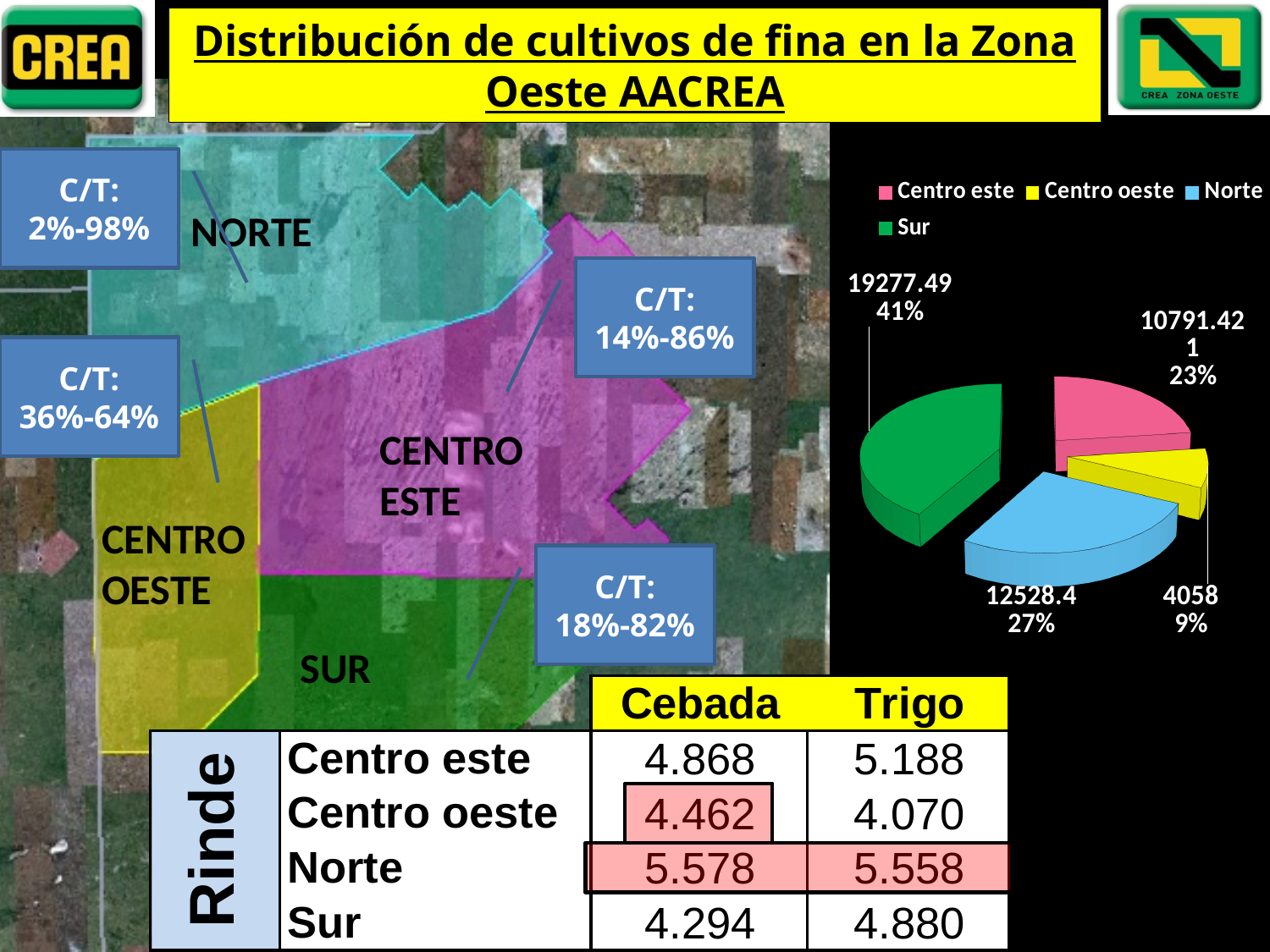
In the pie chart, which is larger: Norte or Centro este? Norte What percentage share does the Sur slice have in the pie chart? 41% What colour is the Sur slice in the pie chart? green Which category has the smallest slice in the pie chart? Centro oeste How many slices does the pie chart have? 4 Which category has the largest slice in the pie chart? Sur What kind of chart is shown on the right side of the slide? pie chart How many categories does the legend of the pie chart list? 4 What percentage share does the Centro oeste slice have in the pie chart? 9% What percentage share does the Norte slice have in the pie chart? 27% What value is labelled on the Sur slice of the pie chart? 19277.49 What value is labelled on the Norte slice of the pie chart? 12528.4